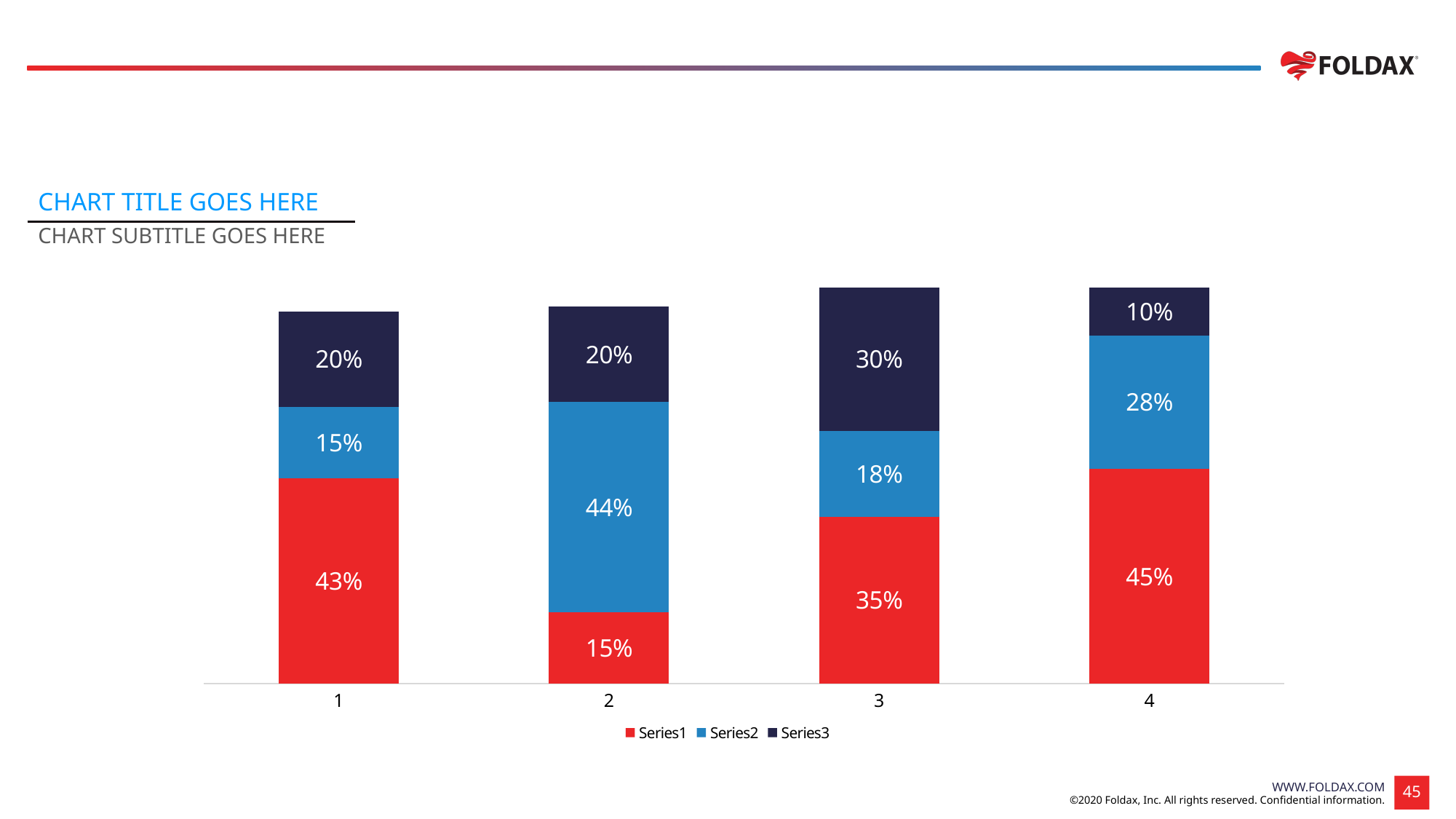
Which is larger: Series1 for category 1 or Series1 for category 3? Series1 for category 1 What is the value of Series1 for category 2? 15% What colour represents Series1 in the chart? Red How many series does the legend list? 3 What is the total of the stacked bar for category 1? 78% Which category has the lowest Series3 value? 4 What is the difference between the Series1 values for category 4 and category 3? 10% What kind of chart is shown on the slide? Stacked bar chart Which category has the highest Series2 value? 2 What is the value of Series3 for category 3? 30% How many categories are shown on the x axis? 4 What is the value of Series2 for category 4? 28%